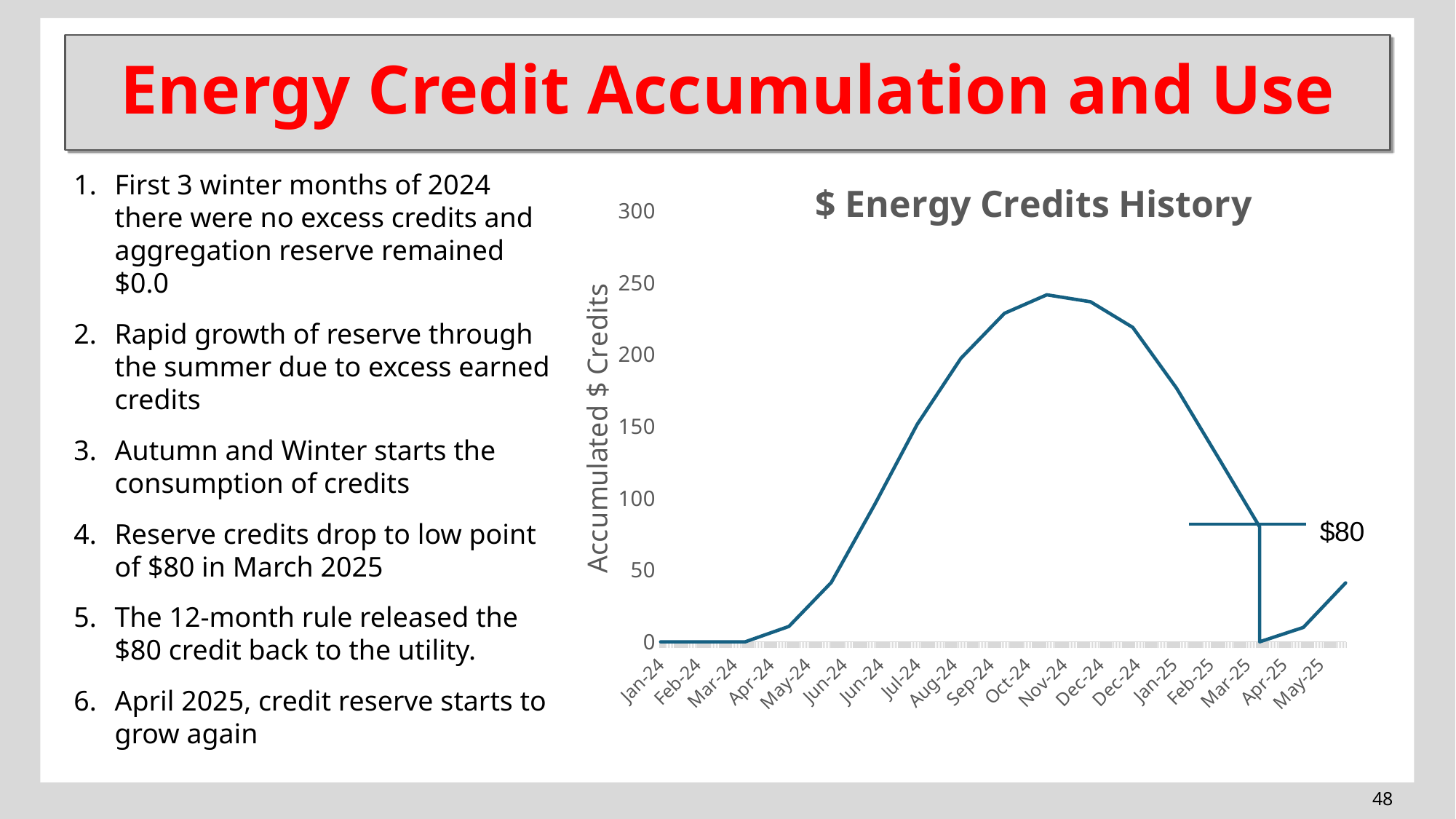
Is the value for Jan-25 greater or less than 100? greater Is the value for May-25 greater or less than 50? less What is the label on the vertical axis of the chart? Accumulated $ Credits Which is larger, the value for Aug-24 or the value for Apr-24? Aug-24 What value is labelled on the chart at the low point in Mar-25? $80 How many month labels are shown along the x axis of the chart? 19 What is the accumulated credit value for Jan-24? 0 What is the title of the chart? $ Energy Credits History Is the value for Nov-24 greater or less than 200? greater Do the values rise or fall from Apr-24 to Nov-24? rise What kind of chart is shown on the slide? line chart Do the values rise or fall from Dec-24 to Mar-25? fall